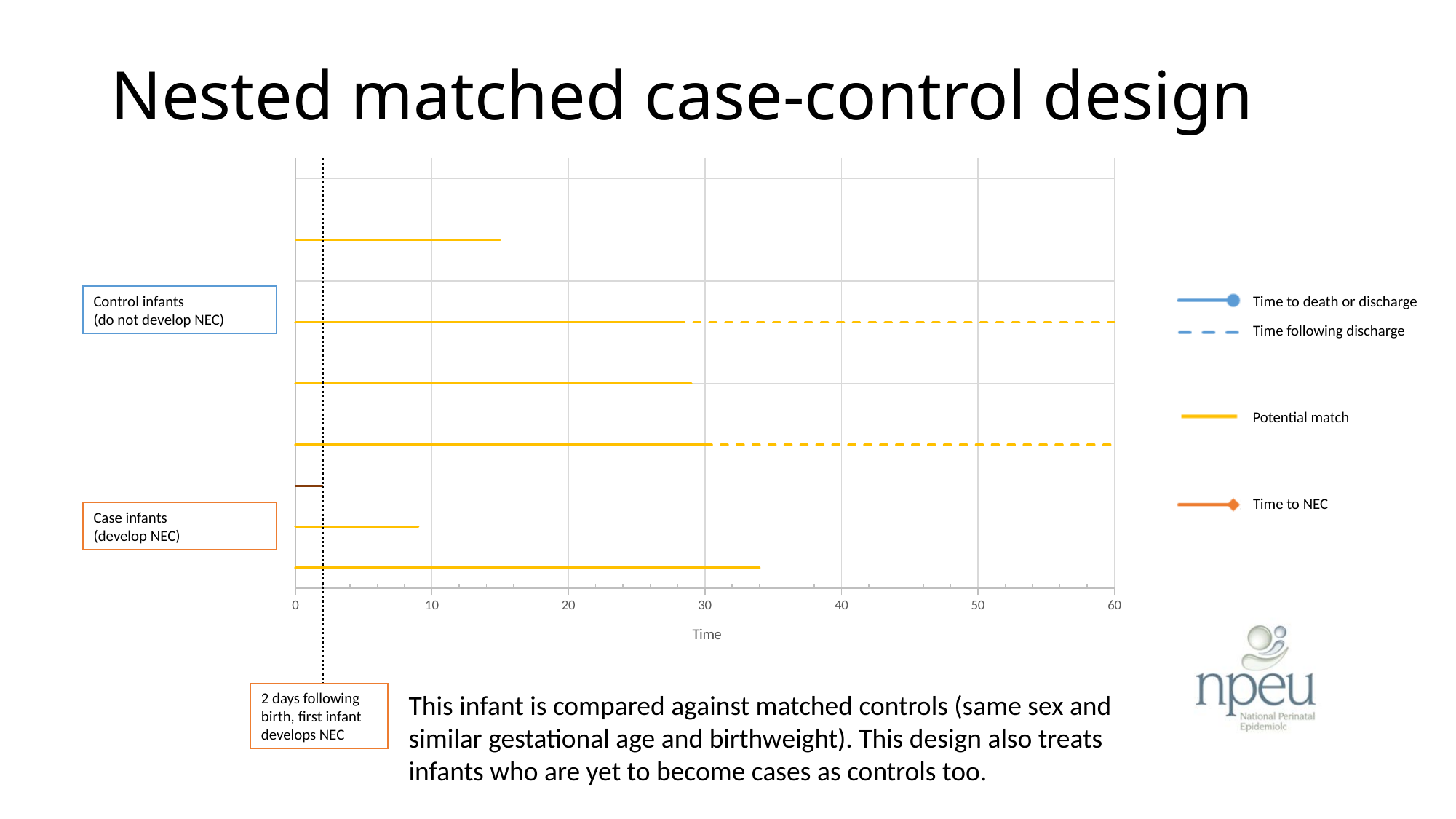
Is the end of the topmost solid line greater or less than 10? greater At what x-axis value is the vertical dotted line drawn? 2 How many infant timelines (horizontal lines) are plotted on the chart? 7 How many entries does the chart's legend list? 4 Which is longer: the topmost solid line or the second line from the bottom? the topmost solid line Which legend entry is drawn with a dashed line? Time following discharge Is the end of the second line from the bottom (the short one in the case infants group) greater or less than 10? less Is the end of the bottommost solid line greater or less than 30? greater Which plotted line is the shortest on the chart? the dark red line (Time to NEC) What is the maximum value shown on the x axis of the chart? 60